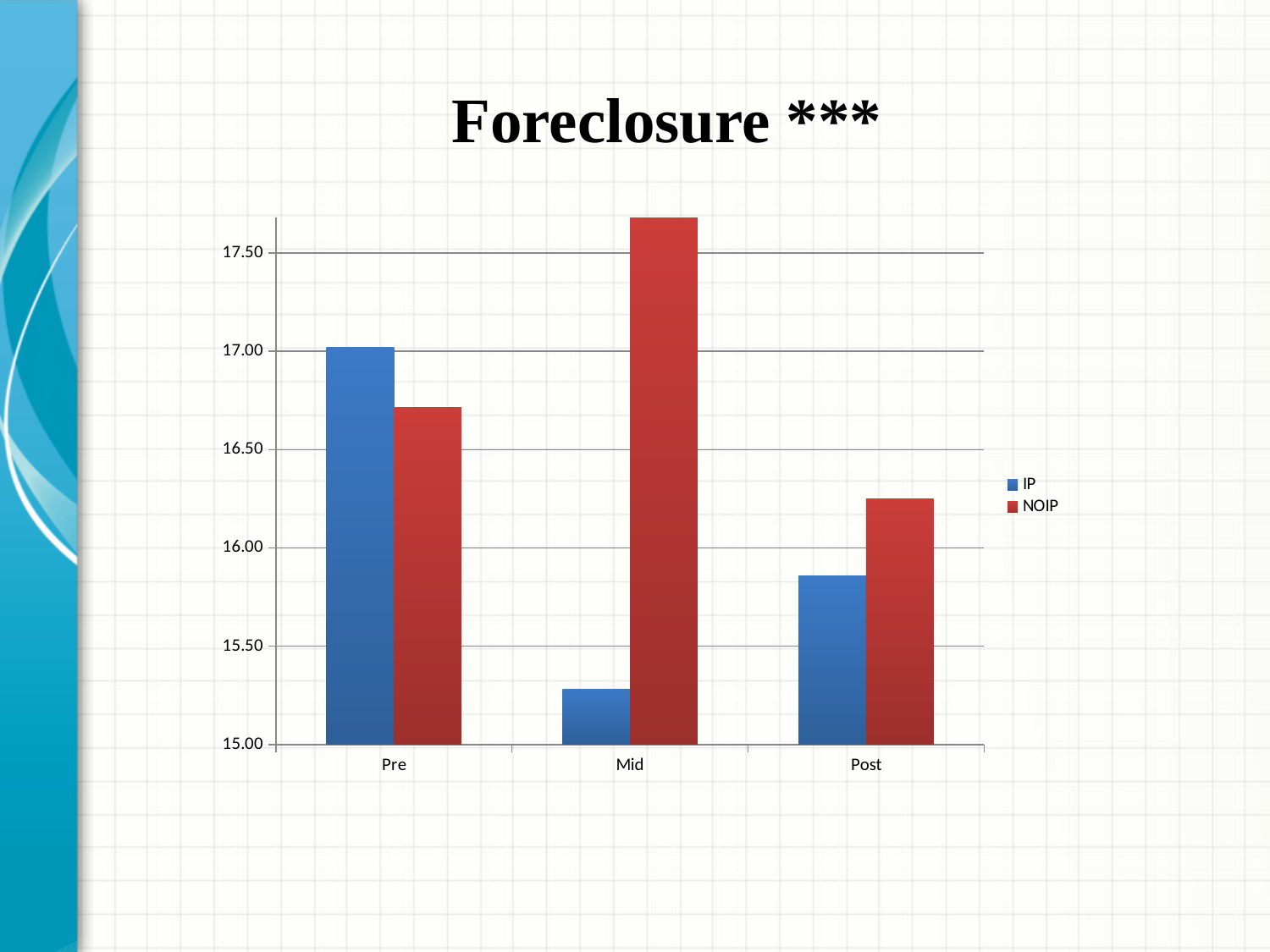
How many categories are shown on the x axis? 3 What kind of chart is shown on the slide? bar chart Is the IP value for Mid greater or less than 15.50? less Which category has the highest NOIP value? Mid Which is larger at Pre, the IP value or the NOIP value? IP How many series does the legend list? 2 What is the title of the chart? Foreclosure *** Which is larger at Mid, the IP value or the NOIP value? NOIP Is the NOIP value for Mid greater or less than 17.50? greater Which series is shown in red? NOIP Which category has the lowest IP value? Mid Which category has the highest IP value? Pre